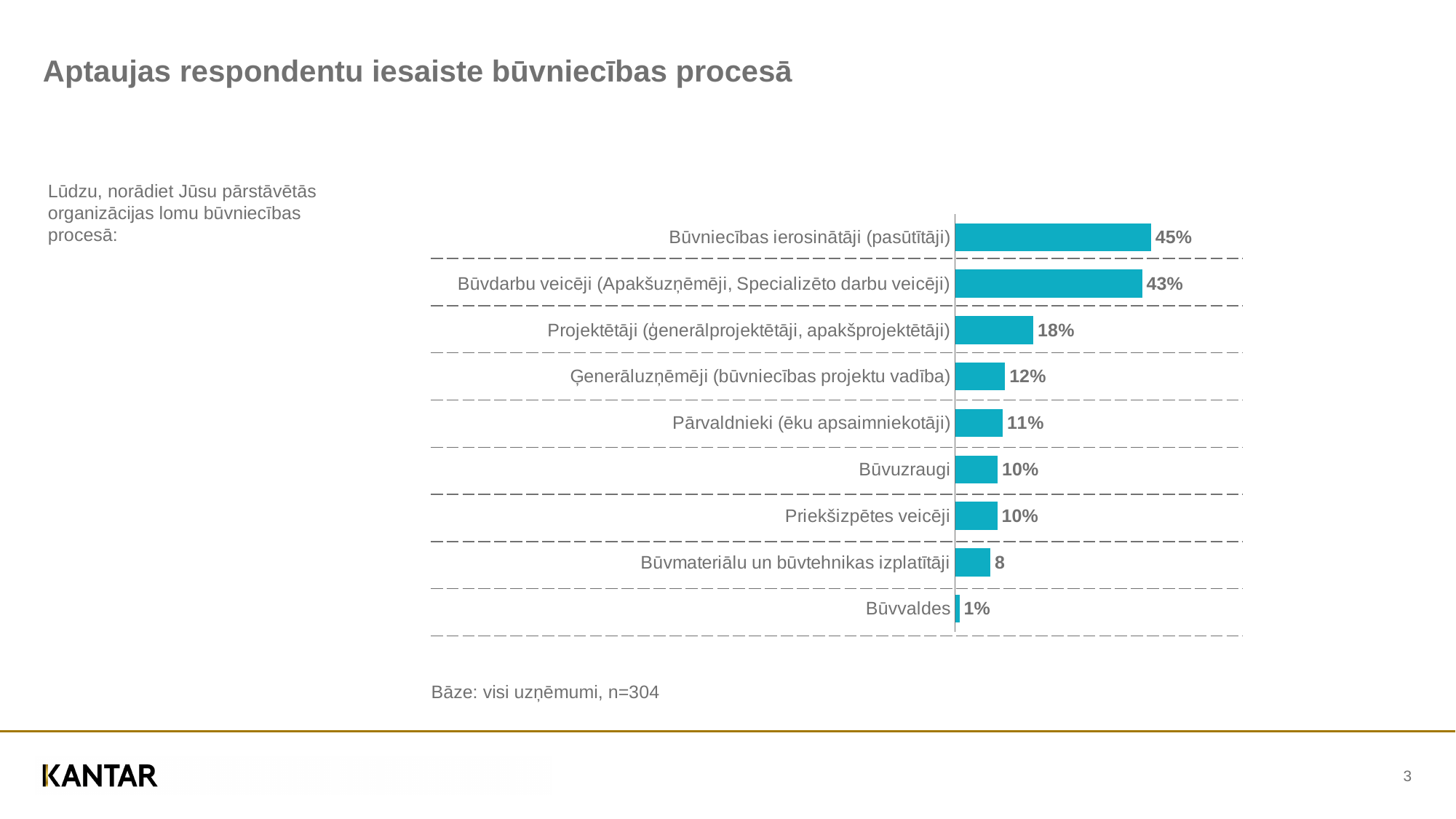
What is the difference between the values for Būvniecības ierosinātāji (pasūtītāji) and Būvdarbu veicēji (Apakšuzņēmēji, Specializēto darbu veicēji)? 2% Which category has the highest value? Būvniecības ierosinātāji (pasūtītāji) What is the value shown for Būvmateriālu un būvtehnikas izplatītāji? 8 What is the base (n) stated below the chart? n=304 What is the value for Būvniecības ierosinātāji (pasūtītāji)? 45% What is the value for Projektētāji (ģenerālprojektētāji, apakšprojektētāji)? 18% Which is larger, the value for Ģenerāluzņēmēji (būvniecības projektu vadība) or the value for Būvuzraugi? Ģenerāluzņēmēji (būvniecības projektu vadība) Which category has the lowest value? Būvvaldes How many categories are shown in the chart? 9 What is the value for Pārvaldnieki (ēku apsaimniekotāji)? 11% What kind of chart is shown on the slide? Bar chart What is the difference between the values for Projektētāji (ģenerālprojektētāji, apakšprojektētāji) and Ģenerāluzņēmēji (būvniecības projektu vadība)? 6%